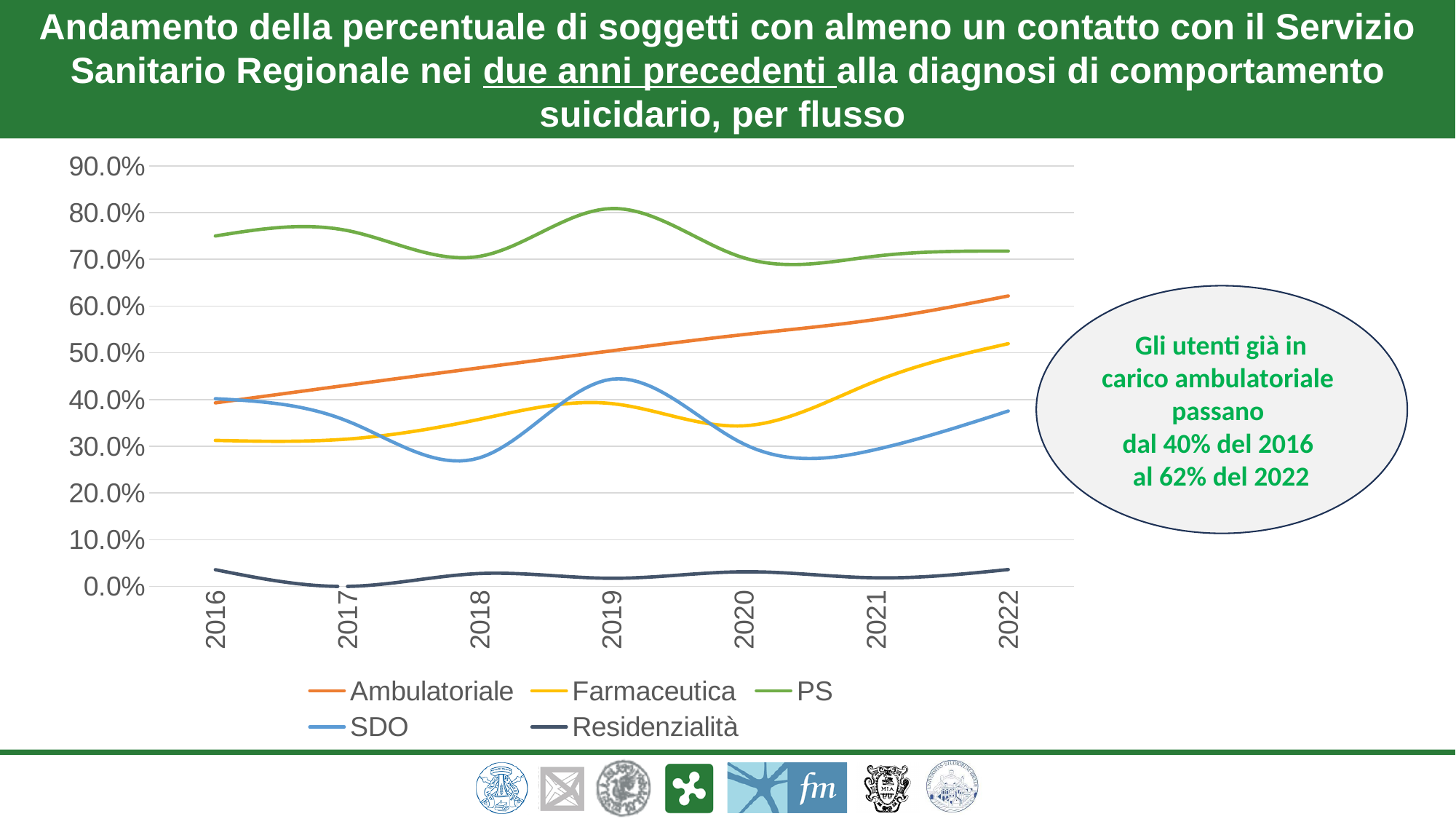
Does the Ambulatoriale line rise or fall from 2016 to 2022? rise Which series has the lowest values across all years? Residenzialità Which series has the highest values across all years? PS According to the slide, what was the Ambulatoriale percentage in 2022? 62% According to the slide, what was the Ambulatoriale percentage in 2016? 40% In 2022, which is larger: PS or Ambulatoriale? PS Is the value for SDO in 2018 greater or less than 30.0%? less How many series does the legend list? 5 How many years are shown on the x axis? 7 By how many percentage points did the Ambulatoriale value increase from 2016 to 2022? 22 Is the value for PS in 2016 greater or less than 70.0%? greater What kind of chart is shown on the slide? line chart